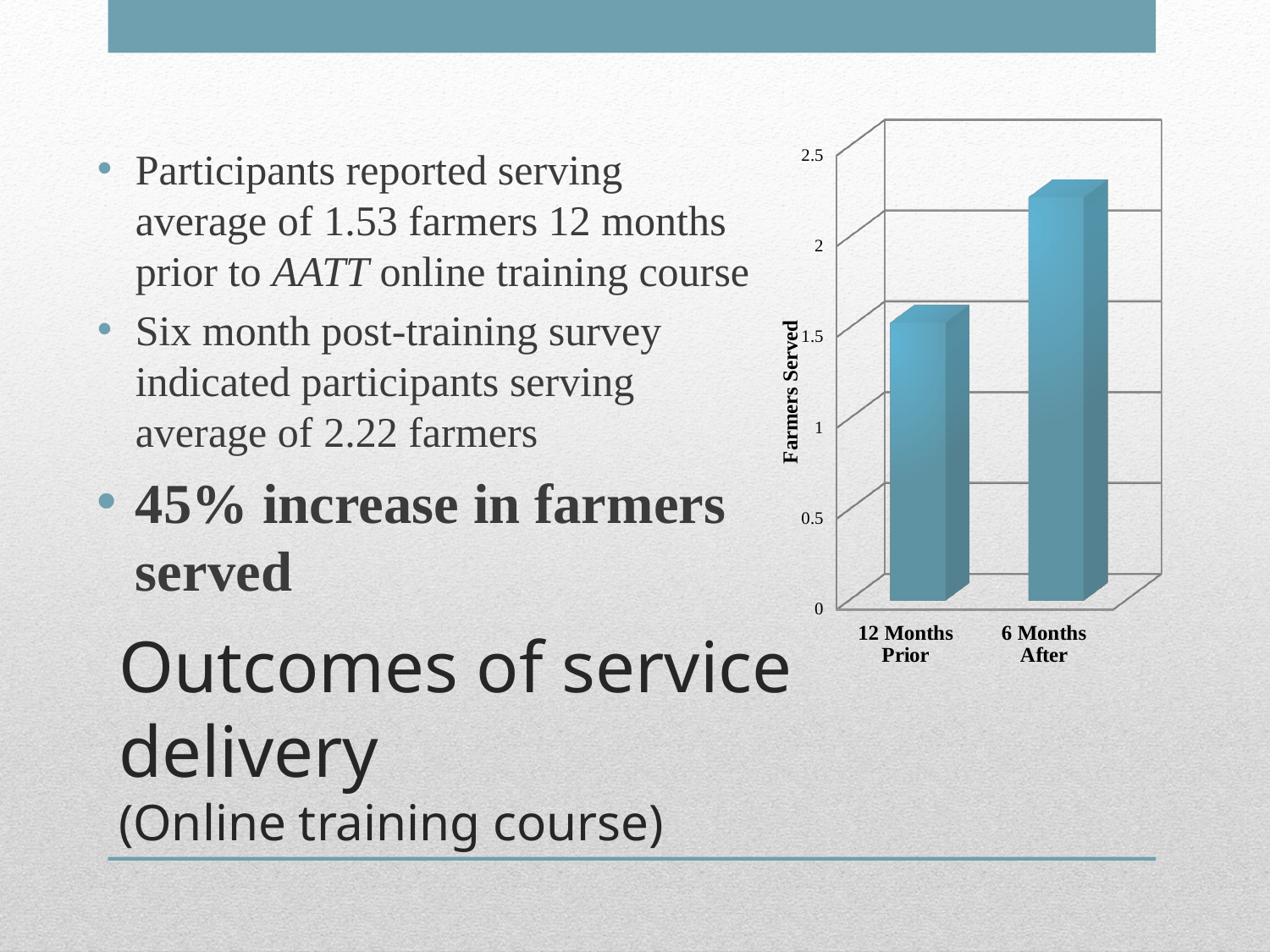
Do the values rise or fall from 12 Months Prior to 6 Months After? rise Is the value for 12 Months Prior greater or less than 2? less Is the value for 6 Months After greater or less than 2.5? less What kind of chart is shown on the slide? bar chart Is the value for 12 Months Prior greater or less than 1? greater Which category has the highest value in the chart? 6 Months After Which category has the lowest value in the chart? 12 Months Prior What is the label on the vertical axis of the chart? Farmers Served How many bars does the chart show? 2 Which is larger, the value for 12 Months Prior or the value for 6 Months After? 6 Months After What is the highest value shown on the vertical axis of the chart? 2.5